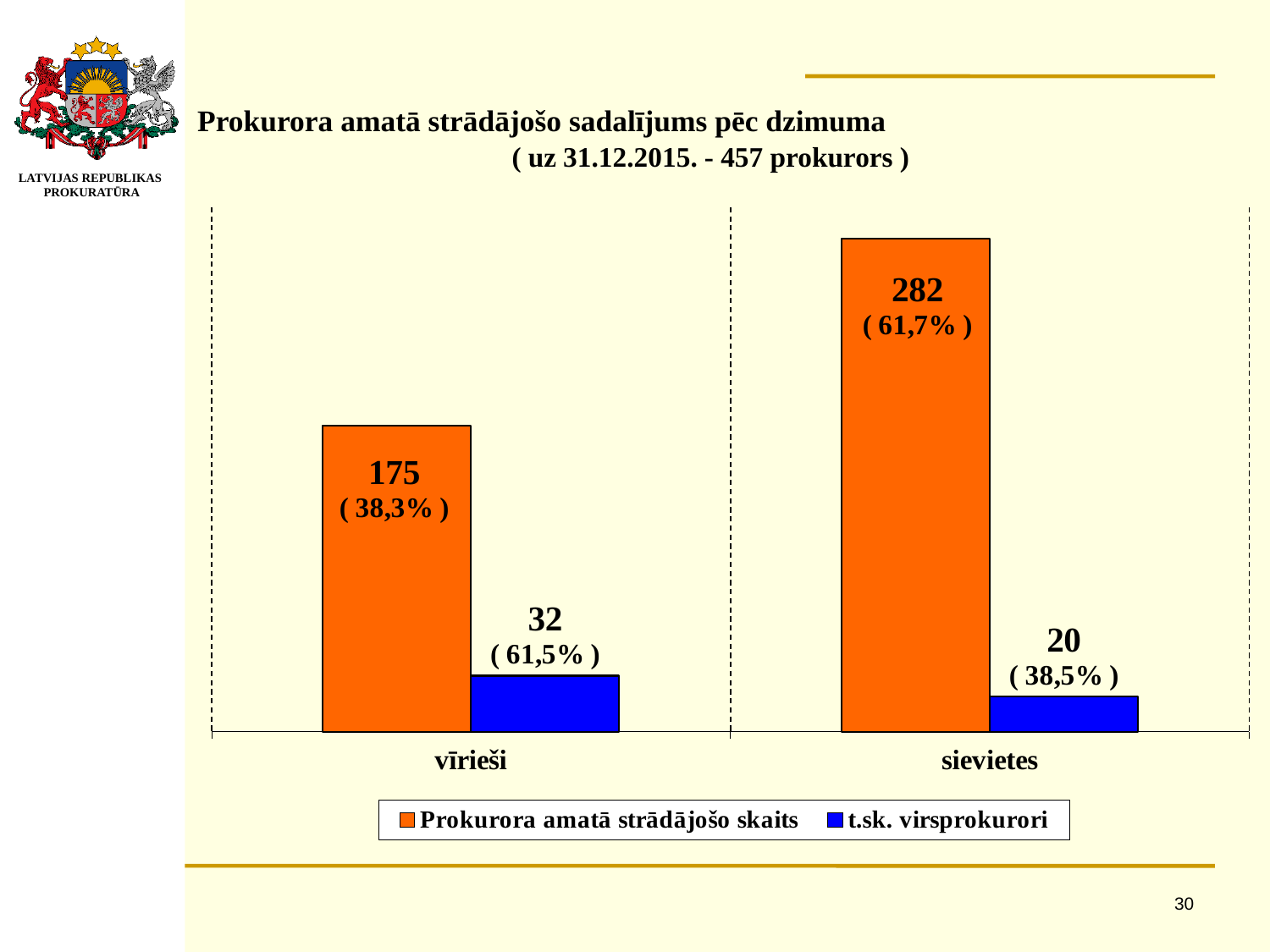
How many series does the legend list? 2 What is the value of "Prokurora amatā strādājošo skaits" for vīrieši? 175 Which category has the higher value for "Prokurora amatā strādājošo skaits"? sievietes What is the value of "t.sk. virsprokurori" for sievietes? 20 Which category has the lower value for "t.sk. virsprokurori"? sievietes What is the value of "Prokurora amatā strādājošo skaits" for sievietes? 282 What is the difference between the "Prokurora amatā strādājošo skaits" values for sievietes and vīrieši? 107 How many categories are shown on the x axis? 2 What is the difference between the "t.sk. virsprokurori" values for vīrieši and sievietes? 12 What percentage is shown next to the 282 value for sievietes? 61,7% What is the value of "t.sk. virsprokurori" for vīrieši? 32 Is the "t.sk. virsprokurori" value larger for vīrieši or for sievietes? vīrieši